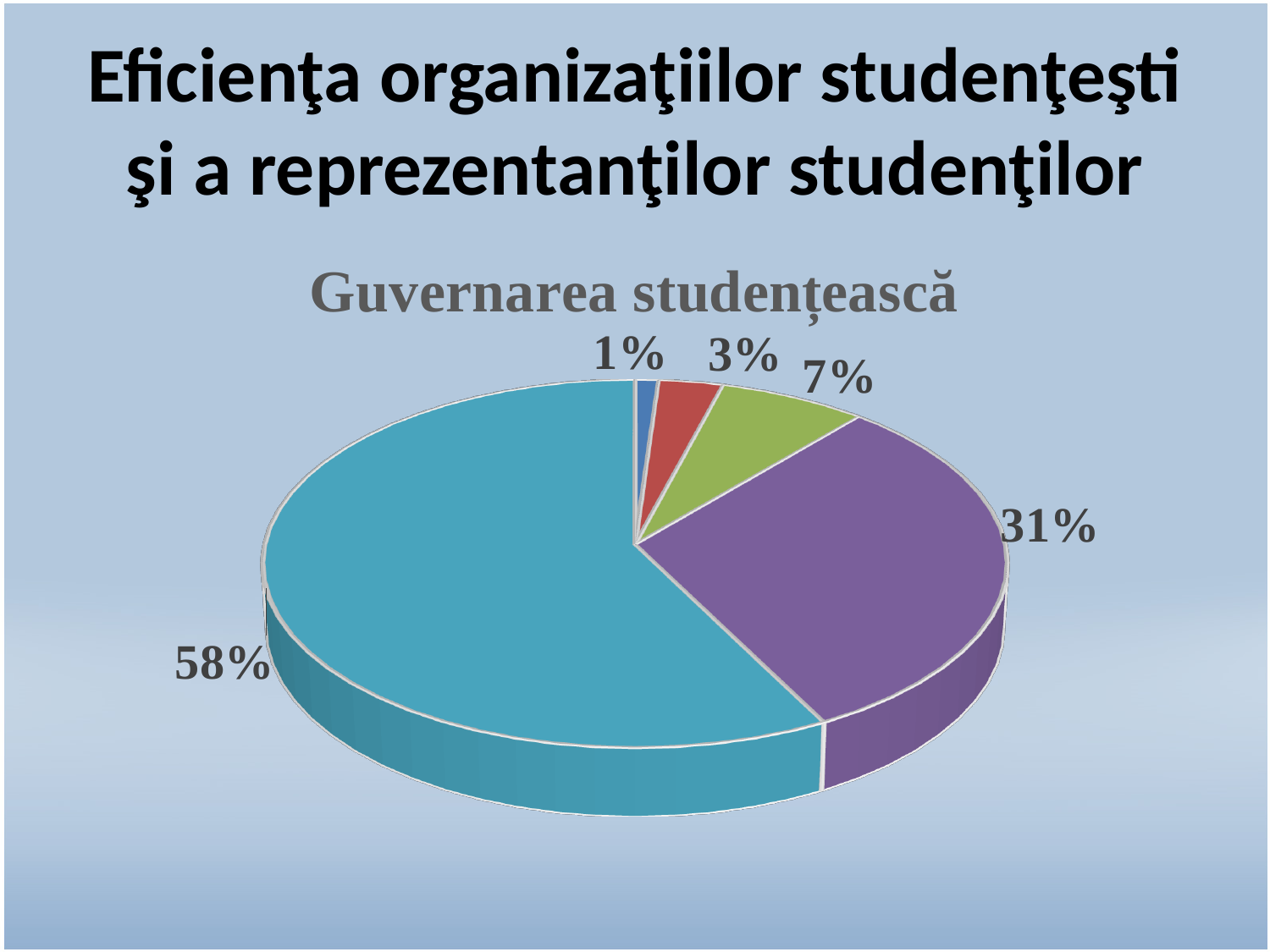
What colour is the slice labelled 1%? blue What percentage is shown for the smallest slice of the pie? 1% What percentage is shown for the largest slice of the pie? 58% What kind of chart is shown on the slide? pie chart What is the title of the chart? Guvernarea studențească What percentage is labelled on the teal (light blue) slice? 58% How many slices does the pie chart have? 5 What percentage is labelled on the purple slice? 31% What is the difference between the largest slice (58%) and the purple slice (31%)? 27 percentage points What percentage is labelled on the green slice? 7% Which slice is larger, the green slice or the red slice? the green slice What percentage is labelled on the red slice? 3%